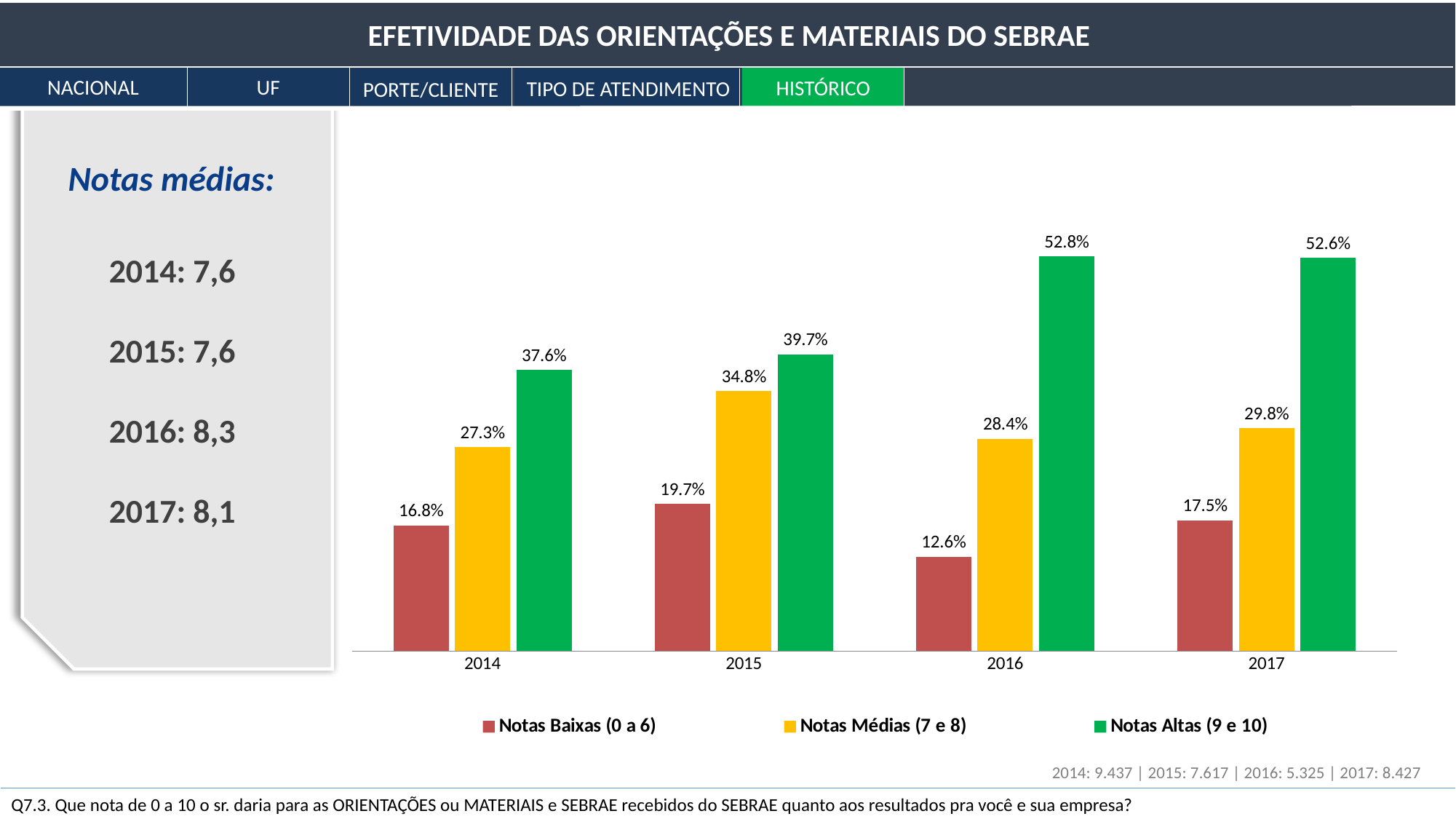
What is the value for Notas Altas (9 e 10) in 2016? 52.8% How many years are shown on the x axis of the chart? 4 What is the value for Notas Médias (7 e 8) in 2017? 29.8% What kind of chart is shown on the slide? Bar chart How many series does the legend list? 3 Which is larger in 2017: Notas Médias (7 e 8) or Notas Baixas (0 a 6)? Notas Médias (7 e 8) What is the value for Notas Baixas (0 a 6) in 2015? 19.7% Which colour represents Notas Altas (9 e 10) in the chart? Green In which year is the Notas Baixas (0 a 6) value lowest? 2016 In which year is the Notas Altas (9 e 10) value lowest? 2014 What is the difference between the Notas Altas (9 e 10) values for 2015 and 2014? 2.1% Does the Notas Médias (7 e 8) series rise or fall from 2014 to 2015? Rise